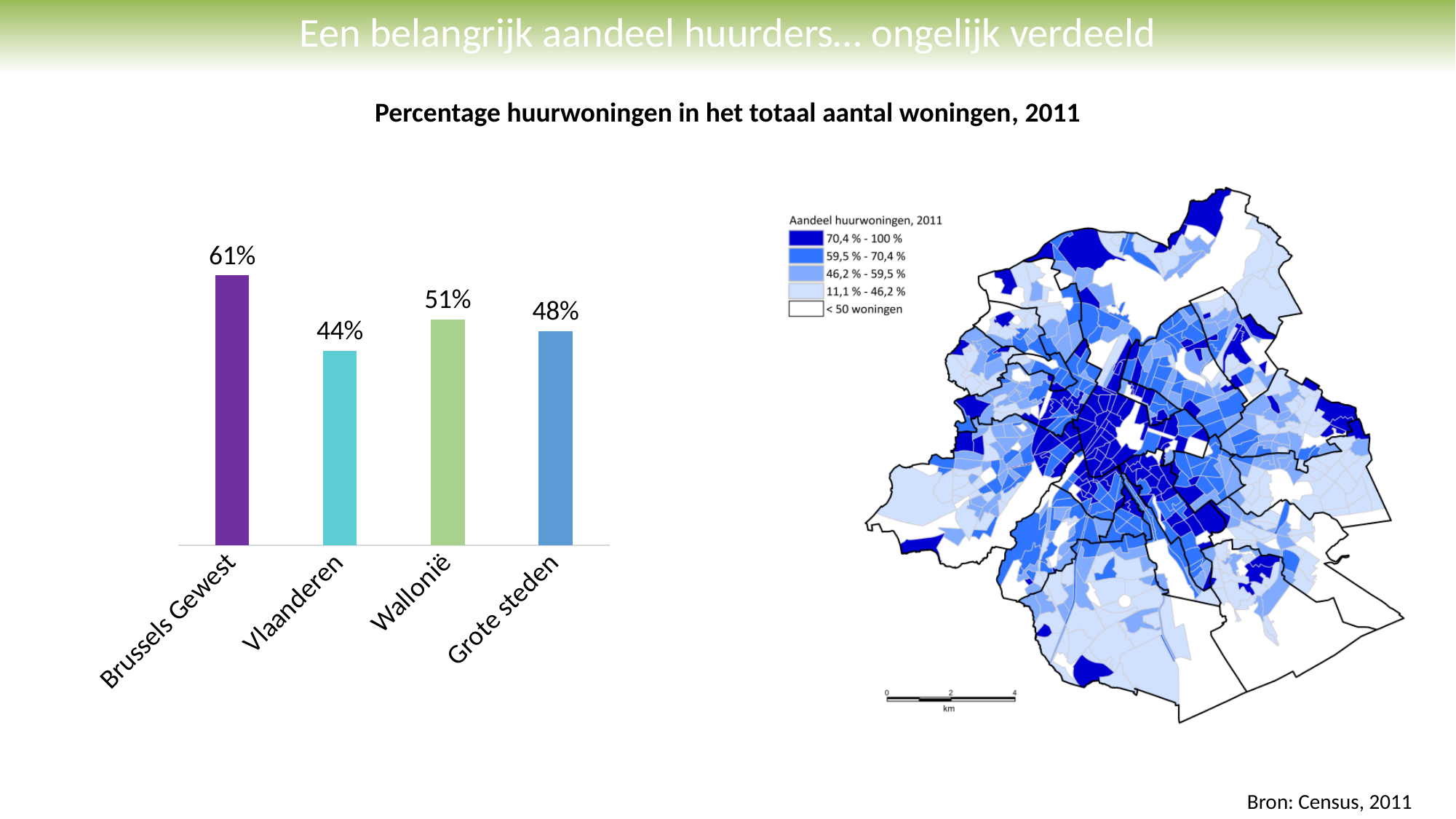
How many categories are shown in the bar chart? 4 Which category has the lowest percentage of rental housing? Vlaanderen What kind of chart is used to show the percentage of rental housing? Bar chart What is the percentage of rental housing for Wallonië? 51% Which category has the highest percentage of rental housing? Brussels Gewest What is the percentage of rental housing for Brussels Gewest? 61% Which has a higher percentage of rental housing, Wallonië or Grote steden? Wallonië What is the difference in percentage points between Wallonië and Grote steden? 3 What is the difference in percentage points between Brussels Gewest and Vlaanderen? 17 What is the title of the bar chart? Percentage huurwoningen in het totaal aantal woningen, 2011 What is the percentage of rental housing for Vlaanderen? 44% What is the percentage of rental housing for Grote steden? 48%